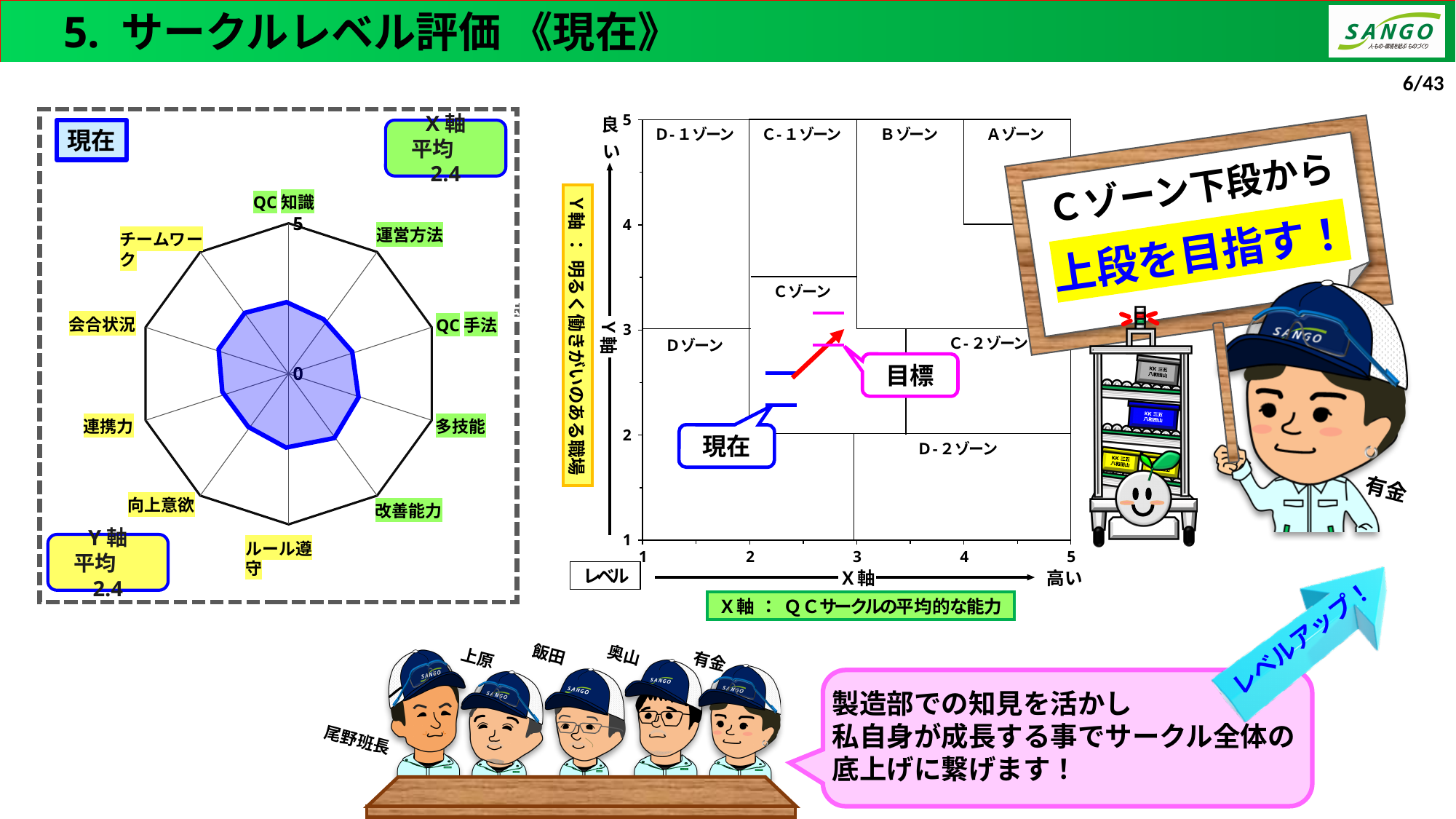
On the radar chart, is the value for 多技能 greater or less than 5? less On the zone chart on the right, is the X軸 value of the 現在 point greater or less than 2? greater On the zone chart on the right, what is the lowest value shown on the X軸 scale? 1 How many categories (axes) does the radar chart on the left have? 10 What is the Y軸平均 value shown next to the radar chart? 2.4 On the zone chart on the right, what is the highest value shown on the Y軸 scale? 5 What is the maximum value shown on the radar chart's axis scale? 5 On the radar chart, is the value for QC知識 greater or less than 5? less On the zone chart on the right, which of the two labelled points, 現在 or 目標, has the higher Y軸 value? 目標 What is the X軸平均 value shown next to the radar chart? 2.4 What kind of chart is the chart on the left side of the slide (labelled 現在)? Radar chart